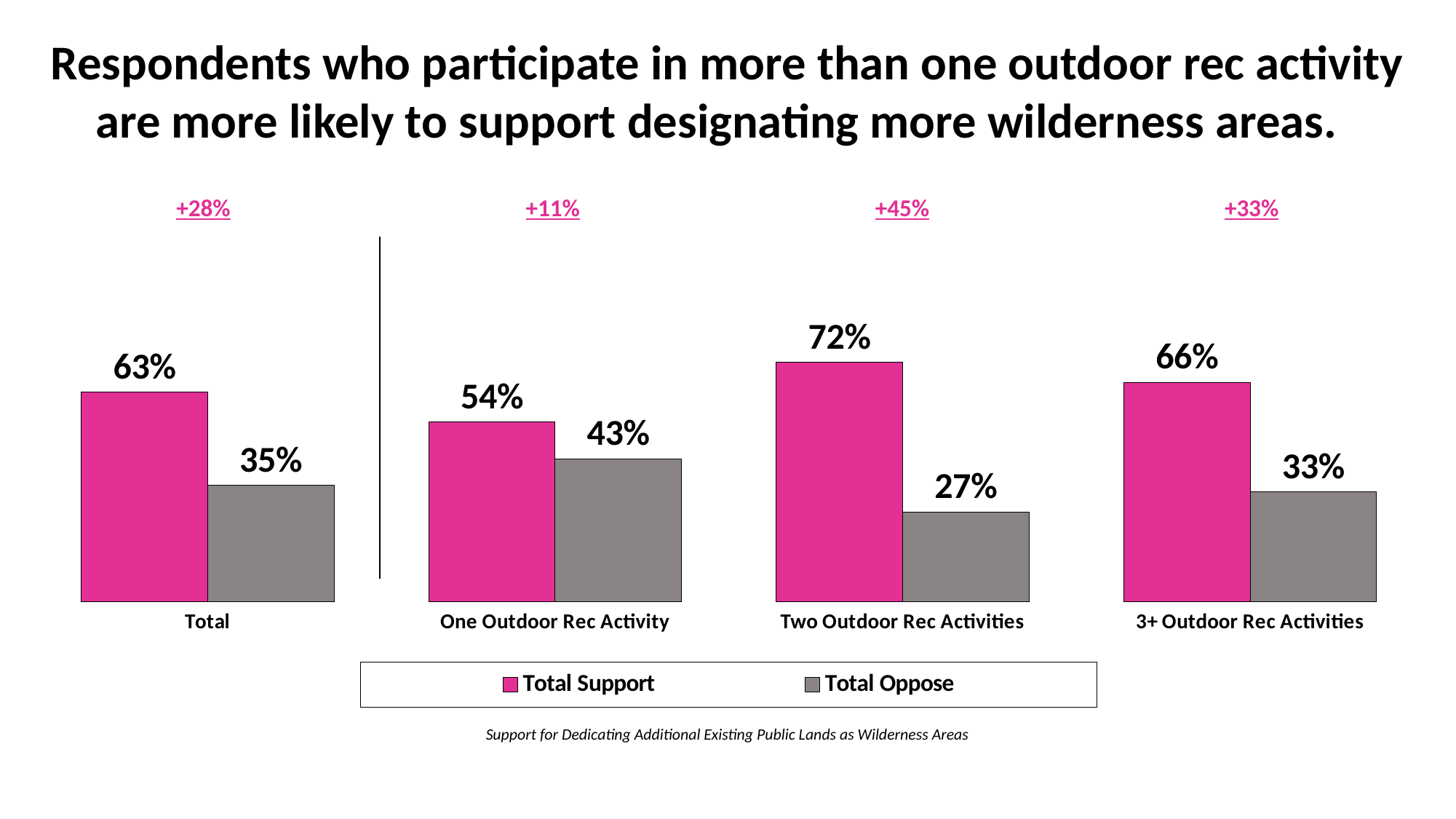
What is the Total Support value for Two Outdoor Rec Activities? 72% What colour represents Total Support in the legend? Pink What is the Total Oppose value for One Outdoor Rec Activity? 43% What is the Total Oppose value for 3+ Outdoor Rec Activities? 33% What is the Total Support value for the Total category? 63% How many categories are shown on the x axis? 4 What kind of chart is shown on the slide? Bar chart Which category has the lowest Total Oppose value? Two Outdoor Rec Activities Which is larger: Total Support for One Outdoor Rec Activity or Total Support for 3+ Outdoor Rec Activities? 3+ Outdoor Rec Activities How many series does the legend list? 2 Which category has the highest Total Support value? Two Outdoor Rec Activities What is the difference between Total Support and Total Oppose for 3+ Outdoor Rec Activities? 33%